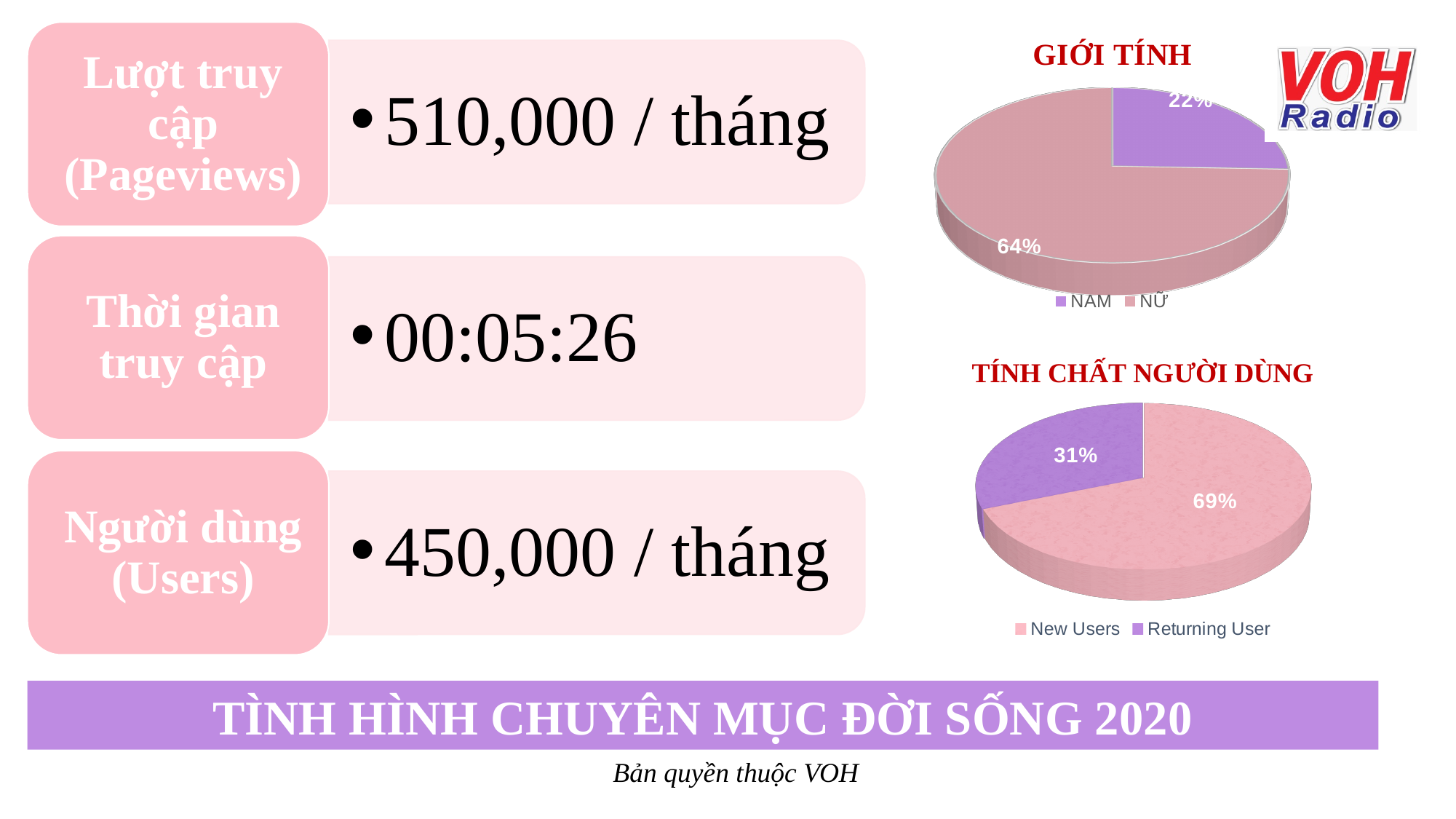
In the "GIỚI TÍNH" chart, what share is labelled for NỮ? 64% How many categories does the legend of the "GIỚI TÍNH" chart list? 2 In the "TÍNH CHẤT NGƯỜI DÙNG" chart, which is larger: New Users or Returning User? New Users In the "GIỚI TÍNH" chart, which category has the largest slice? NỮ In the "TÍNH CHẤT NGƯỜI DÙNG" chart, what share is labelled for New Users? 69% In the "TÍNH CHẤT NGƯỜI DÙNG" chart, what share is labelled for Returning User? 31% In the "TÍNH CHẤT NGƯỜI DÙNG" chart, what colour is the Returning User slice? purple What kind of chart is the "GIỚI TÍNH" chart? pie chart In the "TÍNH CHẤT NGƯỜI DÙNG" chart, by how many percentage points does New Users exceed Returning User? 38 percentage points In the "GIỚI TÍNH" chart, what share is labelled for NAM? 22% In the "TÍNH CHẤT NGƯỜI DÙNG" chart, which category has the smallest slice? Returning User What kind of chart is the "TÍNH CHẤT NGƯỜI DÙNG" chart? pie chart